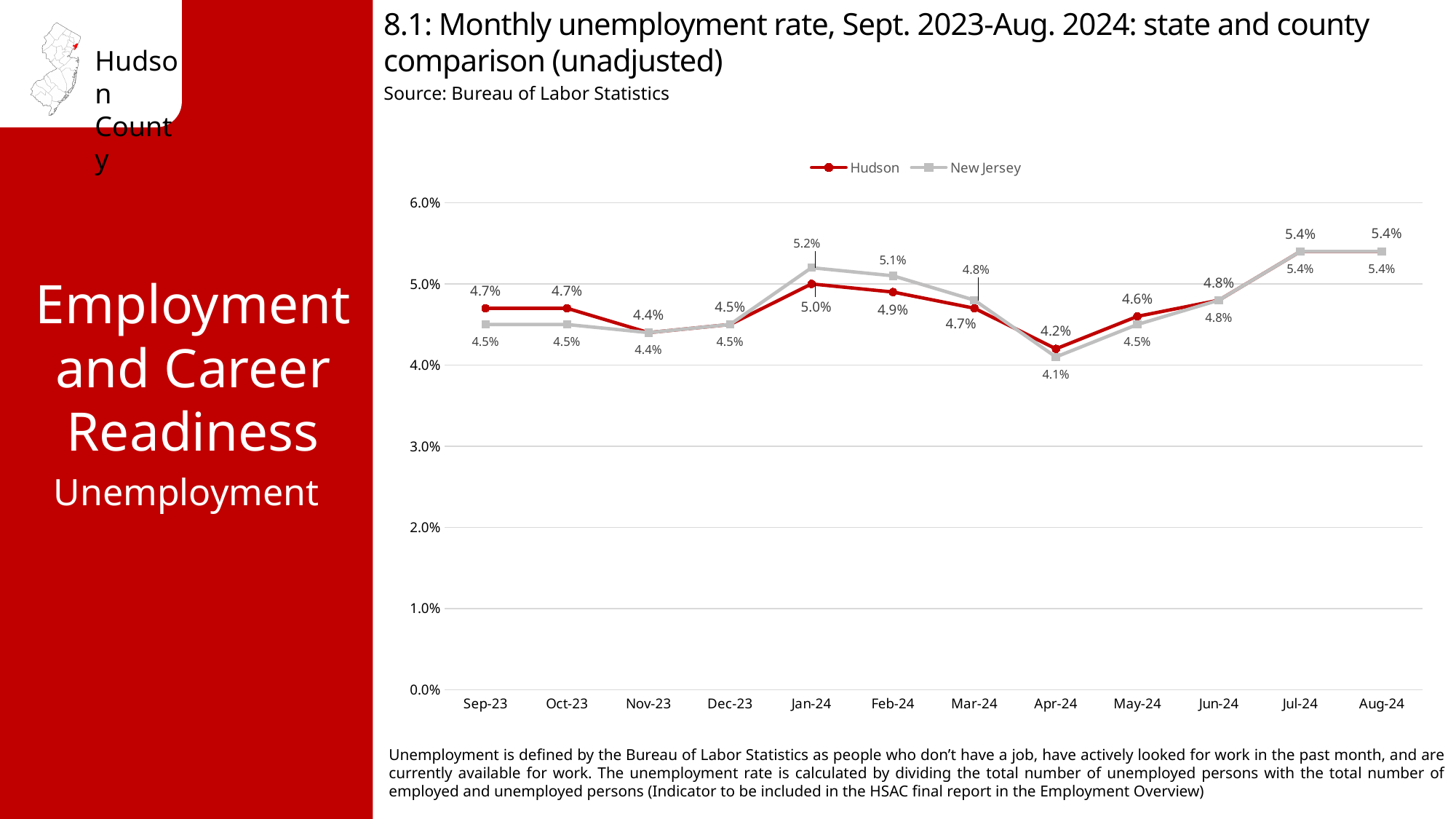
What is the difference between New Jersey's and Hudson's unemployment rates in Jan-24? 0.2% What kind of chart is shown on the slide? Line chart How many months are shown on the x axis? 12 What was New Jersey's unemployment rate in Sep-23? 4.5% How many series does the legend list? 2 Which series had the higher unemployment rate in Sep-23, Hudson or New Jersey? Hudson Which series had the higher unemployment rate in Feb-24, Hudson or New Jersey? New Jersey What was Hudson's unemployment rate in Jan-24? 5.0% In which month did Hudson record its lowest unemployment rate? Apr-24 What was Hudson's unemployment rate in Apr-24? 4.2% Did Hudson's unemployment rate rise or fall from Apr-24 to Aug-24? Rise What was New Jersey's unemployment rate in Jan-24? 5.2%